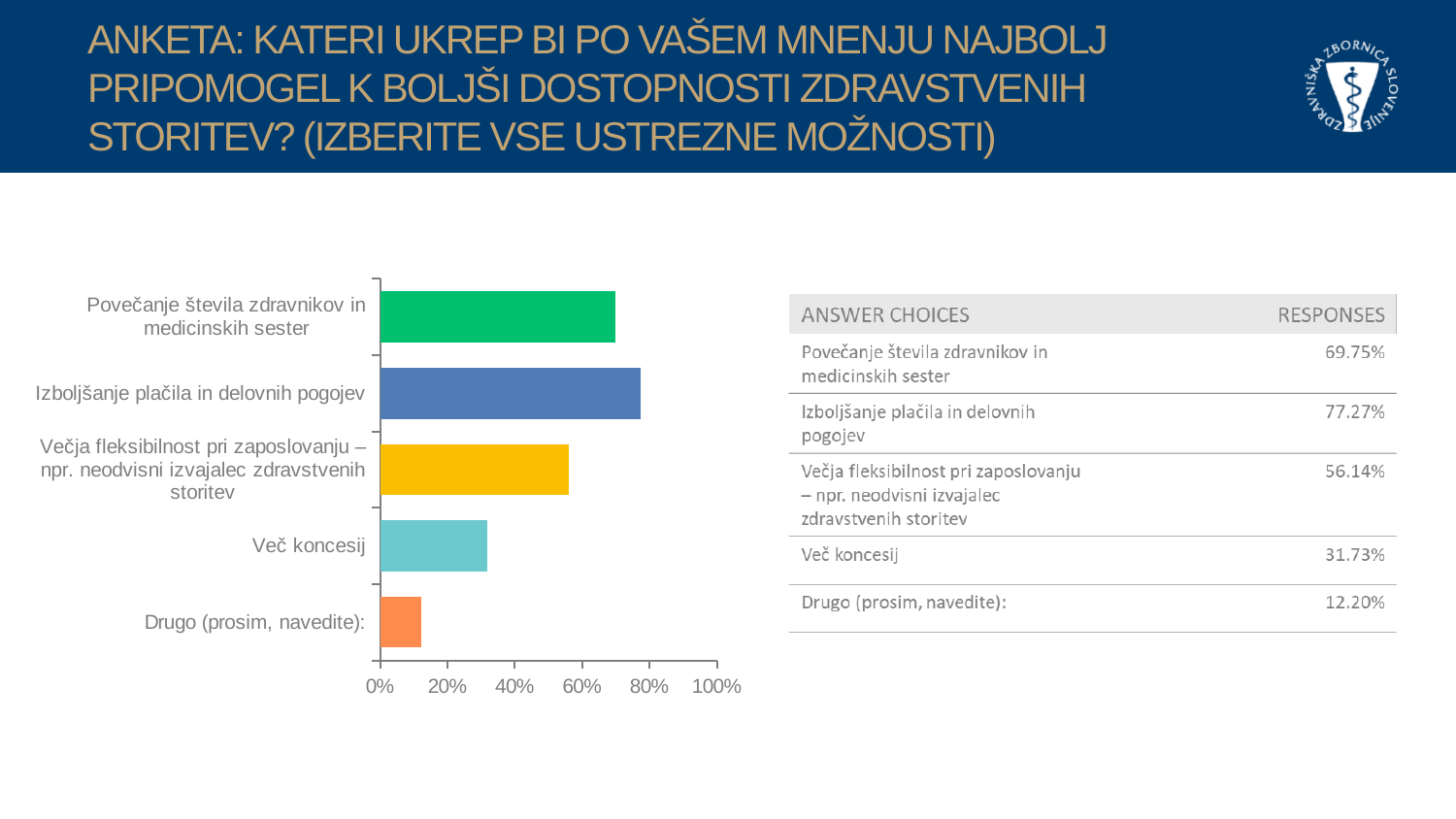
What kind of chart is shown on the slide? bar chart Which category has the lowest value in the bar chart? Drugo (prosim, navedite): Is the value for 'Večja fleksibilnost pri zaposlovanju – npr. neodvisni izvajalec zdravstvenih storitev' greater or less than 40%? greater What is the response value for 'Več koncesij'? 31.73% What is the response value for 'Povečanje števila zdravnikov in medicinskih sester'? 69.75% Which is larger: the value for 'Povečanje števila zdravnikov in medicinskih sester' or the value for 'Več koncesij'? Povečanje števila zdravnikov in medicinskih sester Is the value for 'Drugo (prosim, navedite):' greater or less than 20%? less What is the difference between the values for 'Izboljšanje plačila in delovnih pogojev' and 'Več koncesij'? 45.54% Which category has the highest value in the bar chart? Izboljšanje plačila in delovnih pogojev What is the response value for 'Izboljšanje plačila in delovnih pogojev'? 77.27% How many categories does the bar chart show? 5 What is the maximum value shown on the horizontal axis of the bar chart? 100%